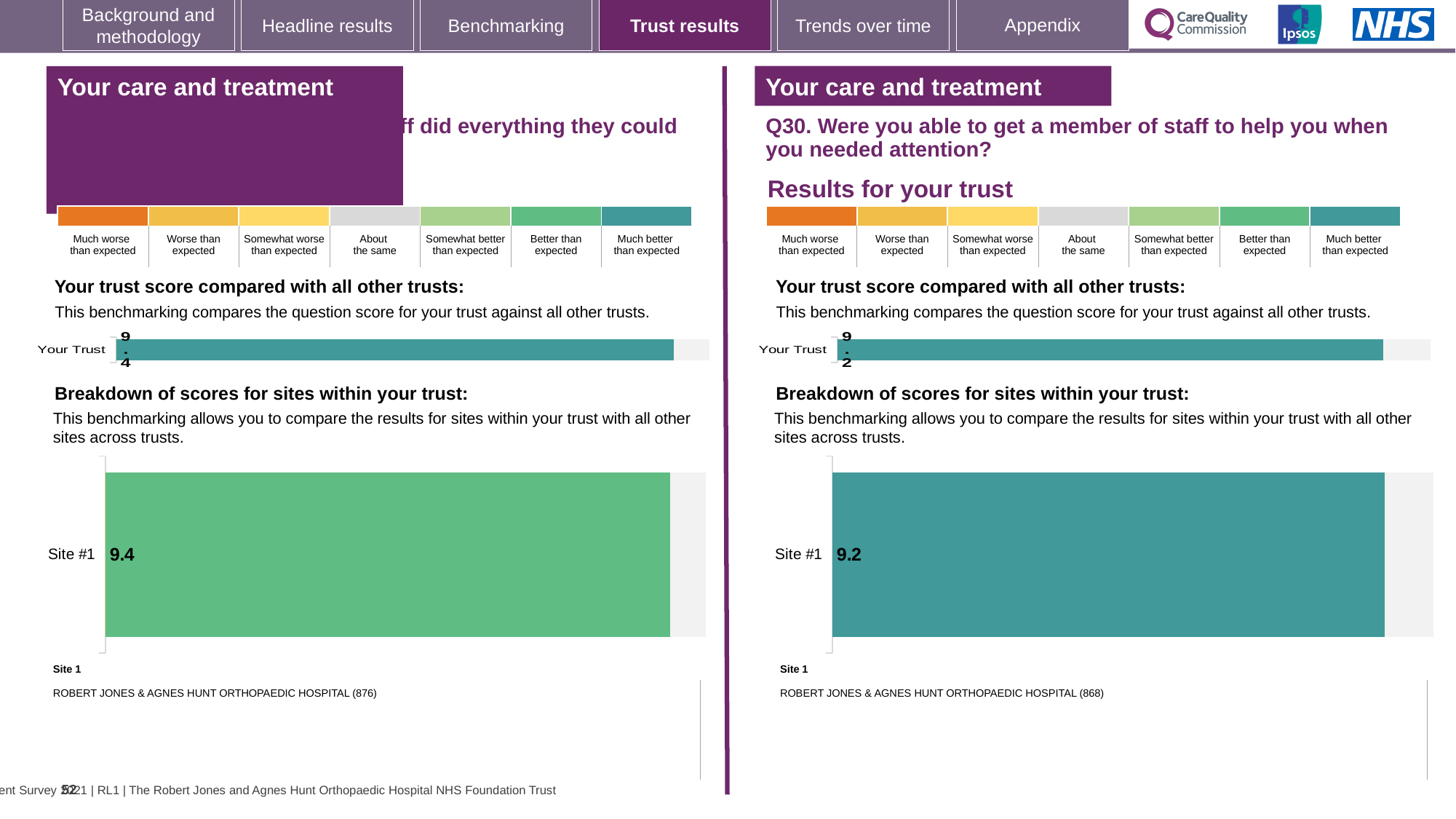
What is the difference between the Site #1 score on the left half of the slide and the Site #1 score for Q30 on the right half? 0.2 On the right half of the slide (Q30), what is the score shown for Your Trust in the 'Your trust score compared with all other trusts' chart? 9.2 On the left half of the slide, what score is shown for Site #1 in the 'Breakdown of scores for sites within your trust' chart? 9.4 What kind of chart is used to show the Your Trust score for Q30? Bar chart On the right half of the slide (Q30), what score is shown for Site #1 in the 'Breakdown of scores for sites within your trust' chart? 9.2 How many categories does the colour scale above the Q30 charts list, from 'Much worse than expected' to 'Much better than expected'? 7 How many sites are shown in the 'Breakdown of scores for sites within your trust' chart for Q30? 1 On the left half of the slide, what is the score shown for Your Trust in the 'Your trust score compared with all other trusts' chart? 9.4 What colour is the Site #1 bar in the Q30 breakdown chart on the right half of the slide? Teal Which is larger: the Your Trust score on the left half of the slide or the Your Trust score for Q30 on the right half? Left half (9.4) What kind of chart is used to show the Site #1 score on the left half of the slide? Bar chart Which site name is listed as Site 1 under the Q30 breakdown chart? ROBERT JONES & AGNES HUNT ORTHOPAEDIC HOSPITAL (868)